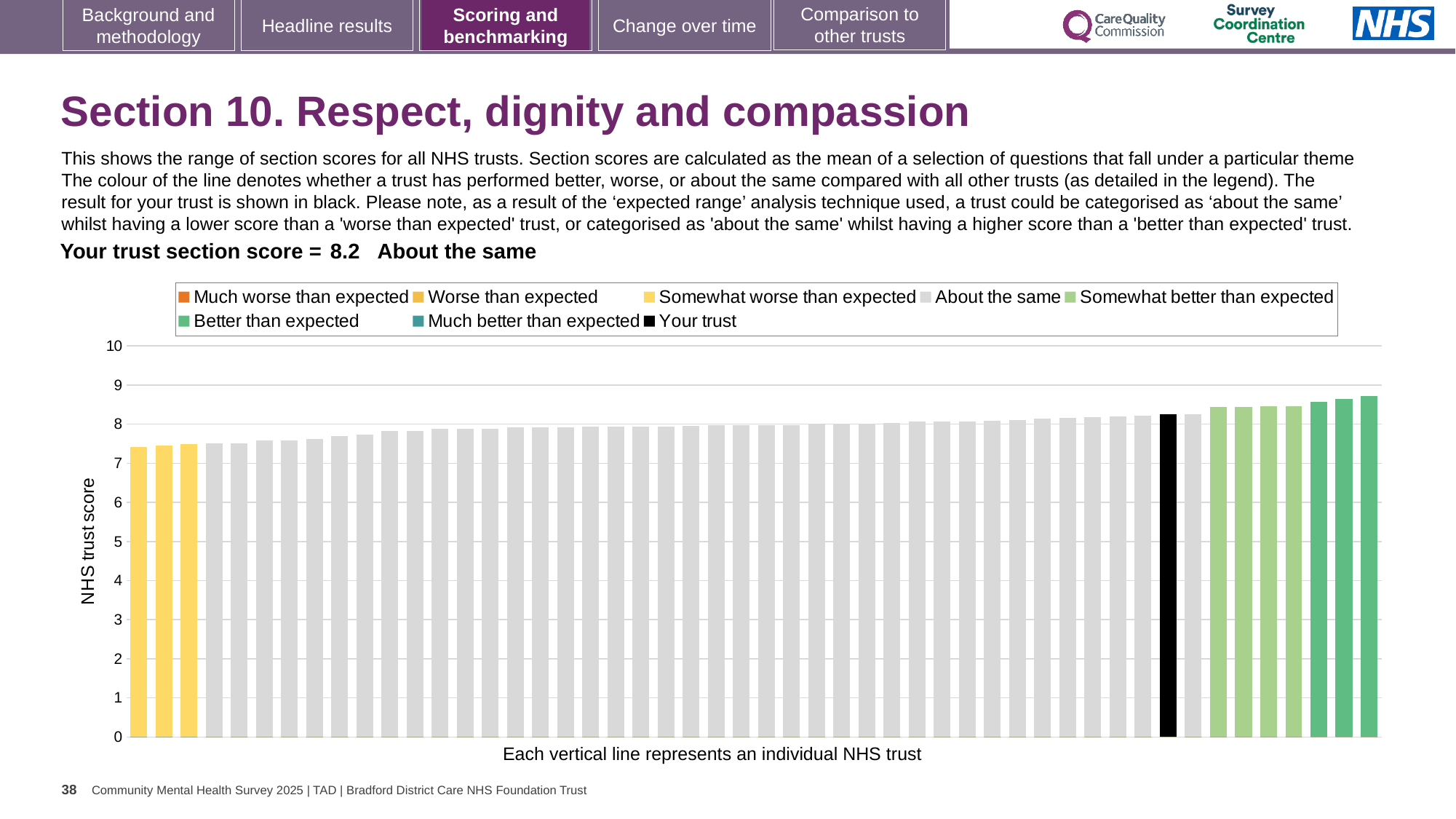
How many yellow 'Somewhat worse than expected' bars are shown in the chart? 3 Which category is your trust placed in according to the slide? About the same What is the section score for your trust shown on the slide? 8.2 How many entries does the chart legend list? 8 Do the bar values rise or fall from left to right along the x axis? rise What is the label on the vertical axis of the chart? NHS trust score Is the value of the lowest bar in the chart greater or less than 8? less Is the value of the black 'Your trust' bar greater or less than 8? greater Is the value of the highest bar in the chart greater or less than 8? greater How many dark green 'Better than expected' bars are shown at the right of the chart? 3 What kind of chart is shown on the slide? bar chart